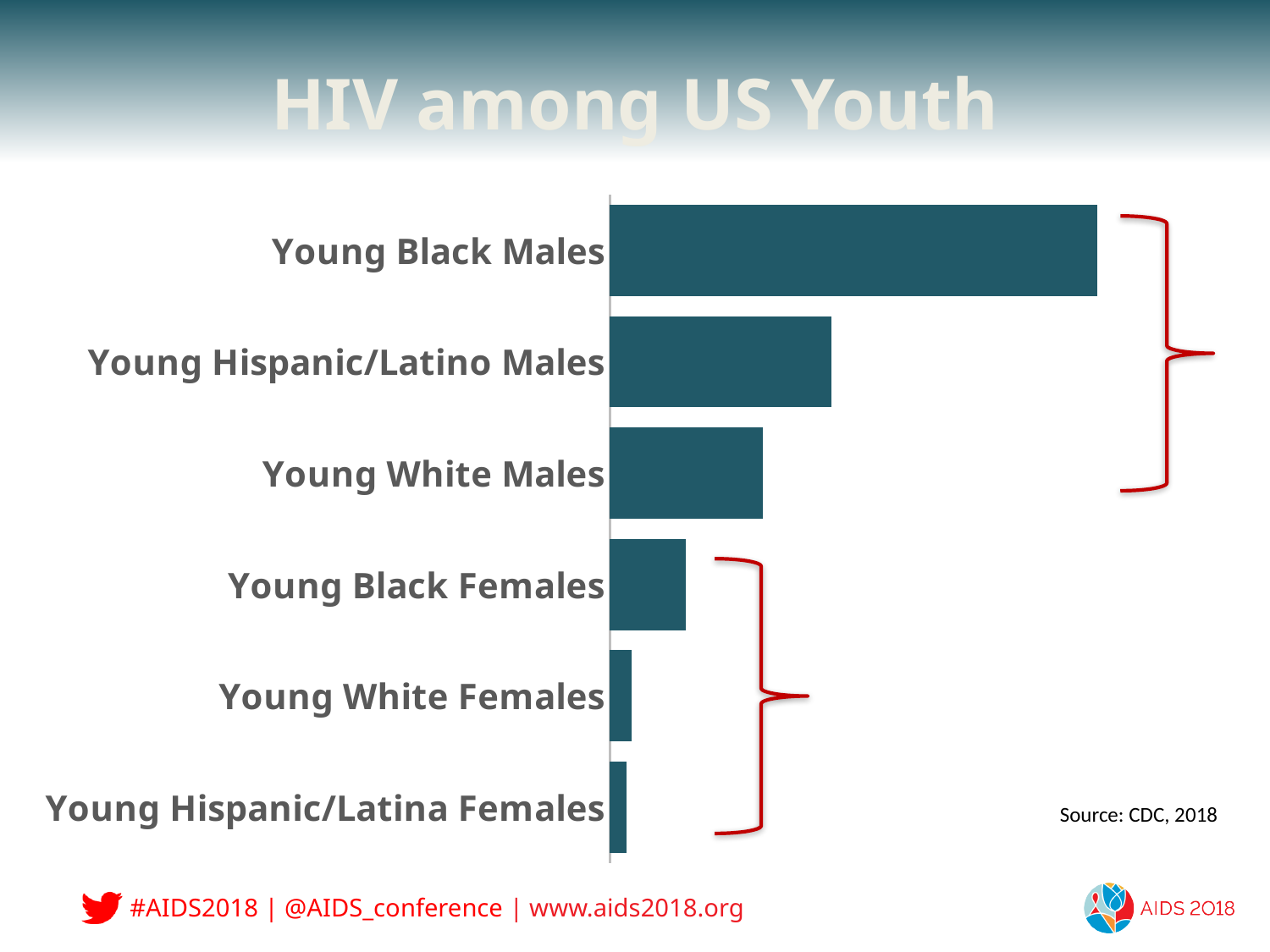
Which is larger, the value for Young Hispanic/Latino Males or the value for Young White Males? Young Hispanic/Latino Males Which category is listed at the bottom of the chart? Young Hispanic/Latina Females What source is cited for the chart's data? CDC, 2018 Which category has the longest bar in the chart? Young Black Males What is the title of the slide's chart? HIV among US Youth What kind of chart is shown on the slide? Bar chart How many categories are plotted in the chart? 6 Do the bars get shorter or longer moving from the top category to the bottom category? Shorter Which is larger, the value for Young Black Females or the value for Young White Females? Young Black Females Which is larger, the value for Young Black Males or the value for Young Hispanic/Latino Males? Young Black Males Which category has the longest bar among the female groups? Young Black Females